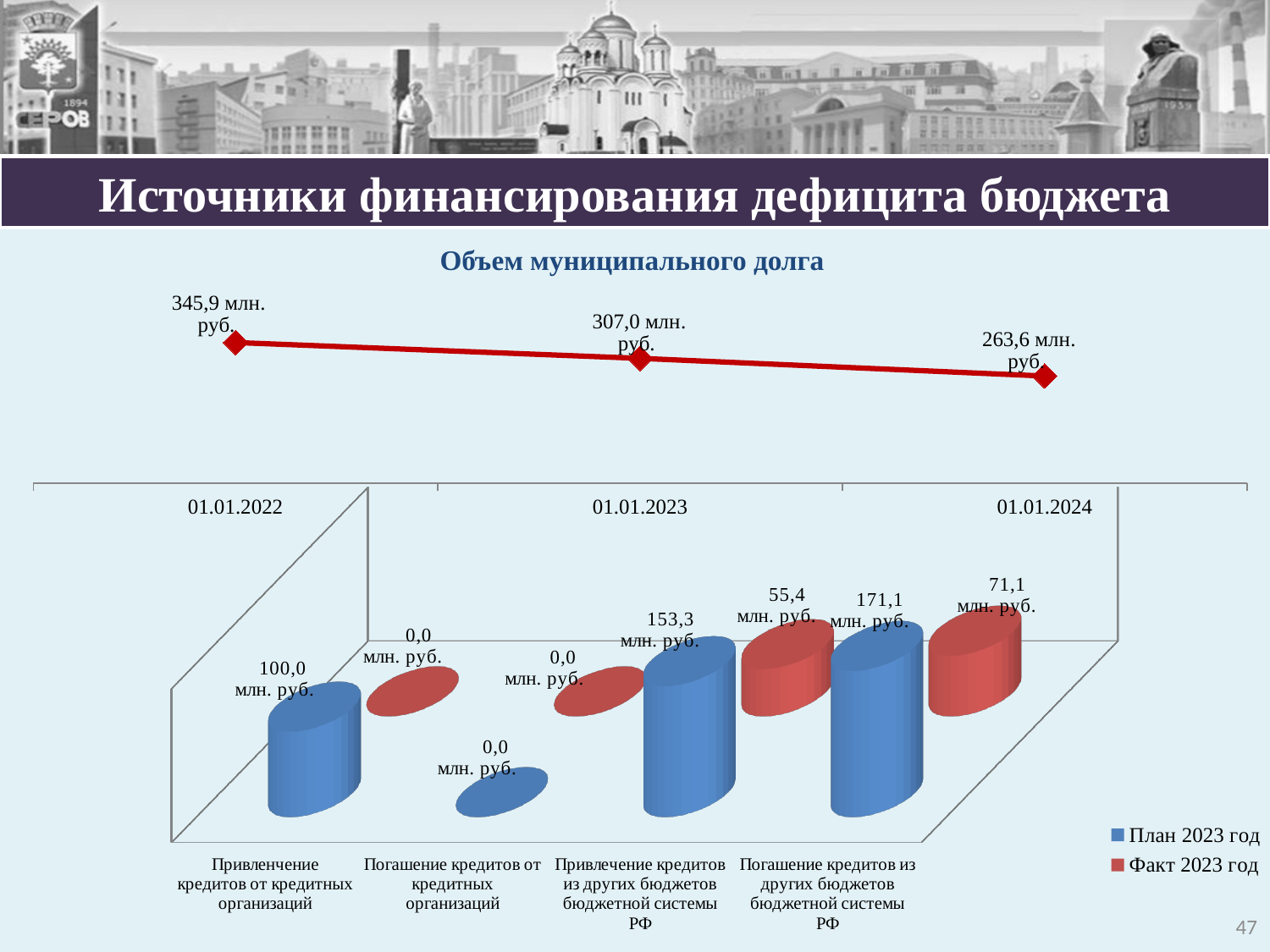
In the line chart 'Объем муниципального долга', what is the value on 01.01.2024? 263,6 млн. руб. In the bar chart at the bottom, what is the 'План 2023 год' value for 'Привлечение кредитов из других бюджетов бюджетной системы РФ'? 153,3 млн. руб. In the bar chart at the bottom, what is the difference between the 'План 2023 год' and 'Факт 2023 год' values for 'Погашение кредитов из других бюджетов бюджетной системы РФ'? 100,0 млн. руб. In the line chart 'Объем муниципального долга', do the values rise or fall from 01.01.2022 to 01.01.2024? fall In the bar chart at the bottom, which is larger for 'Привленчение кредитов от кредитных организаций': the 'План 2023 год' value or the 'Факт 2023 год' value? План 2023 год In the bar chart at the bottom, how many series does the legend list? 2 In the line chart 'Объем муниципального долга', what is the value on 01.01.2022? 345,9 млн. руб. In the bar chart at the bottom, what is the 'Факт 2023 год' value for 'Погашение кредитов из других бюджетов бюджетной системы РФ'? 71,1 млн. руб. In the bar chart at the bottom, which category has the highest 'План 2023 год' value? Погашение кредитов из других бюджетов бюджетной системы РФ In the line chart 'Объем муниципального долга', how many data points are plotted? 3 In the line chart 'Объем муниципального долга', what is the difference between the values on 01.01.2022 and 01.01.2023? 38,9 млн. руб. What kind of chart is the chart at the bottom of the slide? bar chart